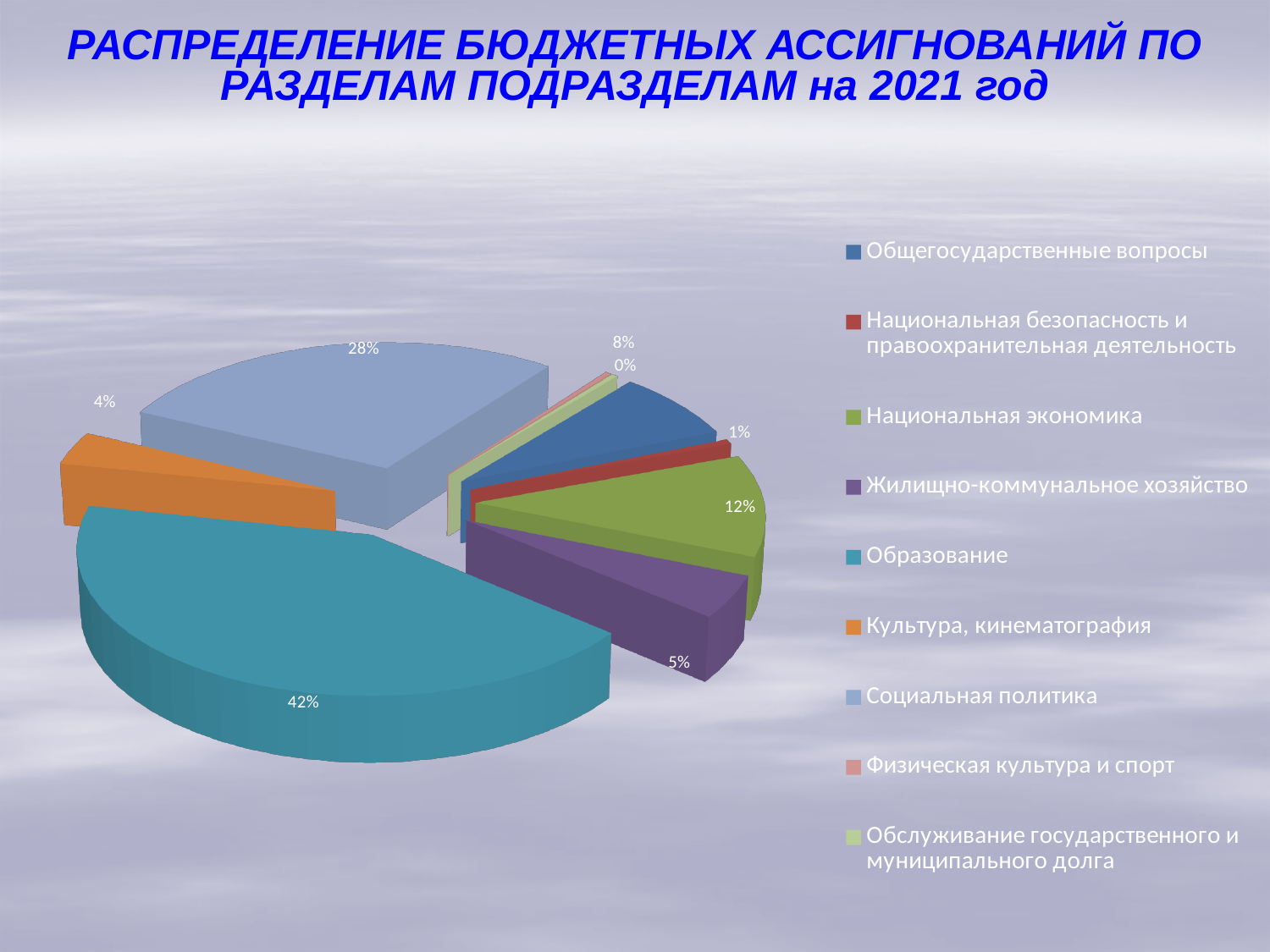
Which category has the largest slice of the pie? Образование What share of the pie does Общегосударственные вопросы have? 8% Which is larger, Социальная политика or Национальная экономика? Социальная политика How many categories does the legend list? 9 What kind of chart is shown on the slide? pie chart What is the difference between the shares of Образование and Социальная политика? 14% What is the title of the chart on the slide? РАСПРЕДЕЛЕНИЕ БЮДЖЕТНЫХ АССИГНОВАНИЙ ПО РАЗДЕЛАМ ПОДРАЗДЕЛАМ на 2021 год What share of the pie does Социальная политика have? 28% What share of the pie does Национальная экономика have? 12% What share of the pie does Культура, кинематография have? 4% What share of the pie does Образование have? 42% What share of the pie does Жилищно-коммунальное хозяйство have? 5%